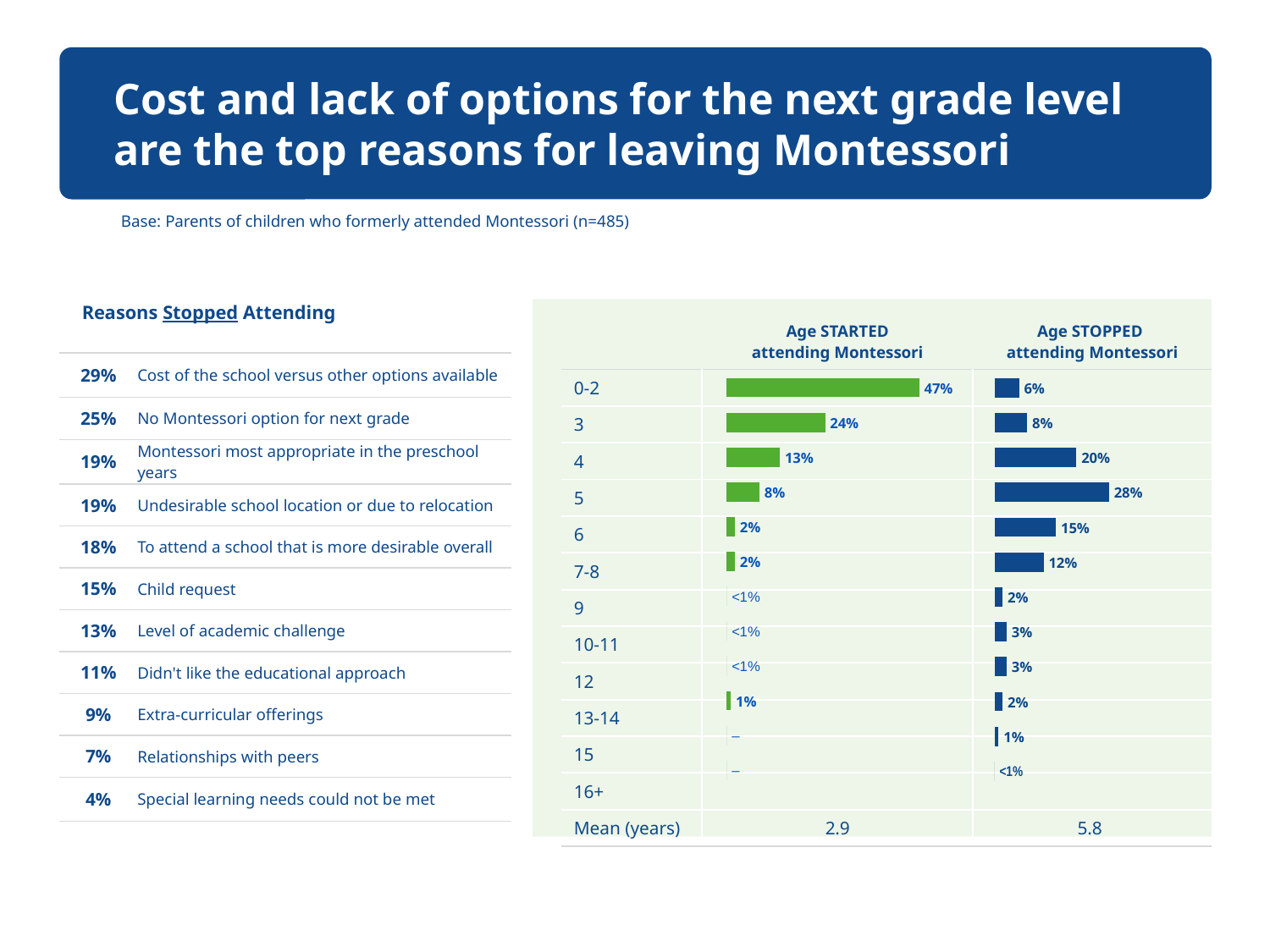
In the age chart on the right, which is larger for age 6: the Age STARTED value or the Age STOPPED value? Age STOPPED In the age chart on the right, what colour are the bars for Age STOPPED attending Montessori? Dark blue In the age chart on the right, what is the difference between the Age STARTED and Age STOPPED values for age 3? 16% In the age chart on the right, what is the mean age (years) at which children stopped attending Montessori? 5.8 What kind of chart is used on the right to show the ages children started and stopped attending Montessori? Bar chart In the age chart on the right, which age group has the highest value for Age STOPPED attending Montessori? 5 In the age chart on the right, what percentage of children stopped attending Montessori at age 4? 20% In the age chart on the right, what percentage of children started attending Montessori at age 0-2? 47% In the age chart on the right, what percentage of children stopped attending Montessori at age 5? 28% How many age groups are listed in the age chart on the right? 12 In the age chart on the right, which age group has the highest value for Age STARTED attending Montessori? 0-2 In the age chart on the right, what is the mean age (years) at which children started attending Montessori? 2.9